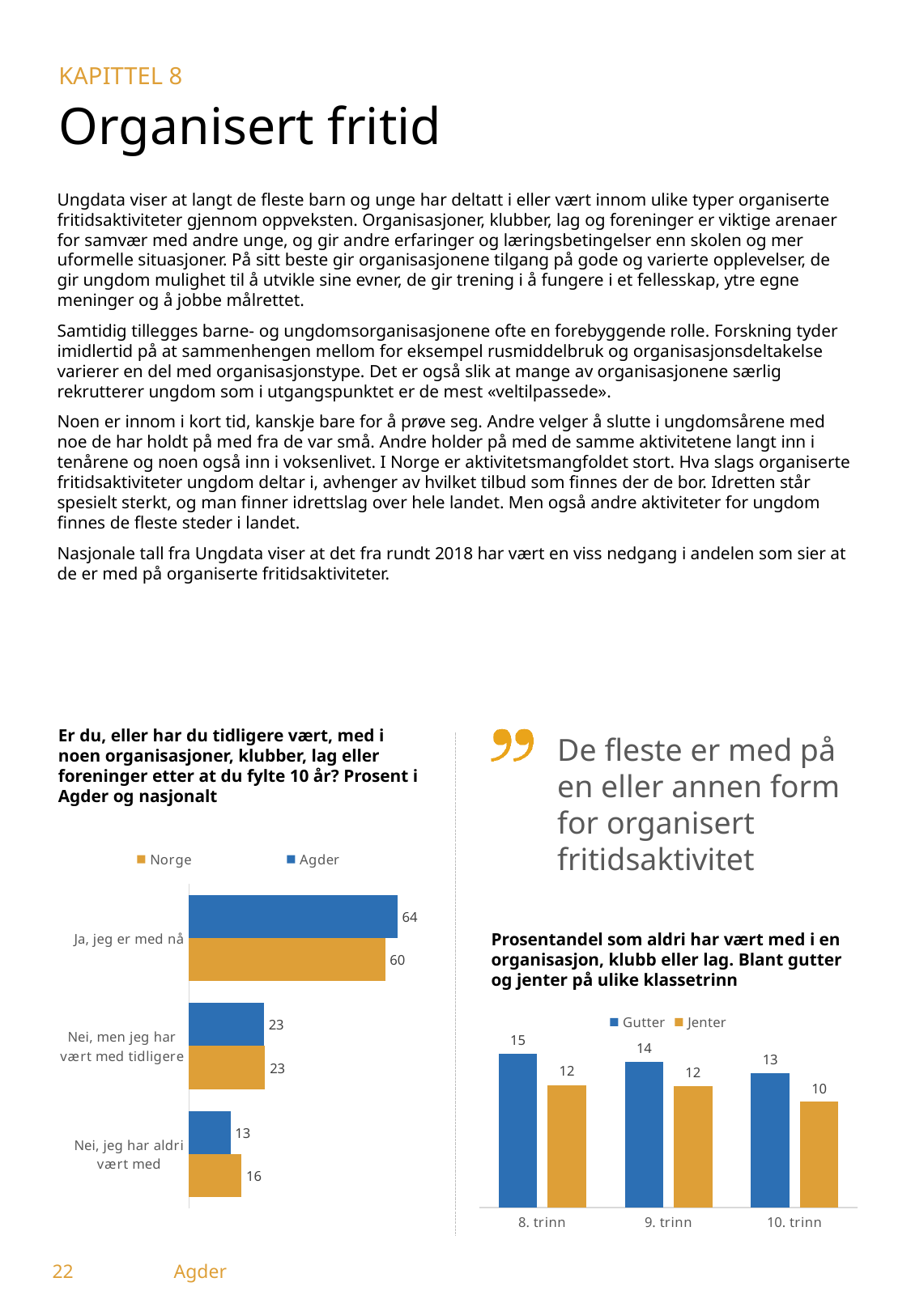
What kind of chart is the right chart ("Prosentandel som aldri har vært med i en organisasjon...")? bar chart In the left chart ("Er du, eller har du tidligere vært, med i noen organisasjoner..."), which is larger for "Nei, jeg har aldri vært med": Norge or Agder? Norge In the right chart ("Prosentandel som aldri har vært med i en organisasjon..."), what is the value for Gutter in 8. trinn? 15 In the left chart ("Er du, eller har du tidligere vært, med i noen organisasjoner..."), what is the value for Norge for "Nei, jeg har aldri vært med"? 16 In the left chart ("Er du, eller har du tidligere vært, med i noen organisasjoner..."), how many categories are shown? 3 In the left chart ("Er du, eller har du tidligere vært, med i noen organisasjoner..."), what is the difference between Agder and Norge for "Ja, jeg er med nå"? 4 In the right chart ("Prosentandel som aldri har vært med i en organisasjon..."), what is the value for Jenter in 10. trinn? 10 In the left chart ("Er du, eller har du tidligere vært, med i noen organisasjoner..."), what is the value for Agder for "Ja, jeg er med nå"? 64 In the left chart ("Er du, eller har du tidligere vært, med i noen organisasjoner..."), how many series does the legend list? 2 In the right chart ("Prosentandel som aldri har vært med i en organisasjon..."), do the Gutter values rise or fall from 8. trinn to 10. trinn? fall In the right chart ("Prosentandel som aldri har vært med i en organisasjon..."), what is the difference between Gutter and Jenter in 9. trinn? 2 In the left chart ("Er du, eller har du tidligere vært, med i noen organisasjoner..."), which category has the highest value for Agder? Ja, jeg er med nå